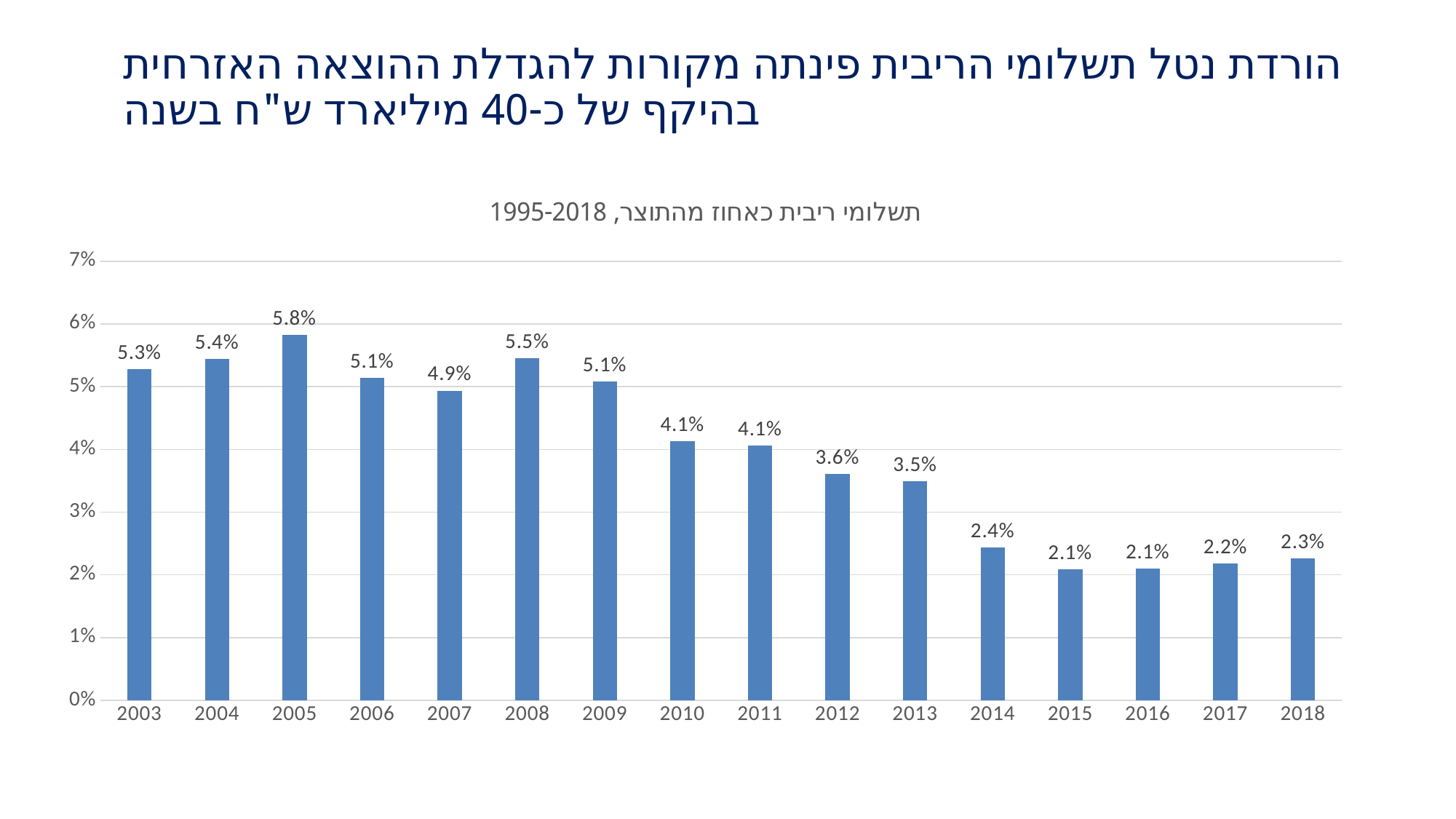
What is the value for 2018? 2.3% What kind of chart is this? bar chart What is the difference between the values for 2003 and 2013? 1.8 percentage points Is the value for 2012 greater or less than 3%? greater What is the value for 2013? 3.5% How many years are shown on the x axis? 16 What is the difference between the values for 2005 and 2018? 3.5 percentage points Do the values generally rise or fall from 2003 to 2018? fall Is the value for 2014 greater or less than 3%? less What is the value for 2005? 5.8% Which is larger, the value for 2008 or the value for 2006? 2008 Which year has the highest value? 2005